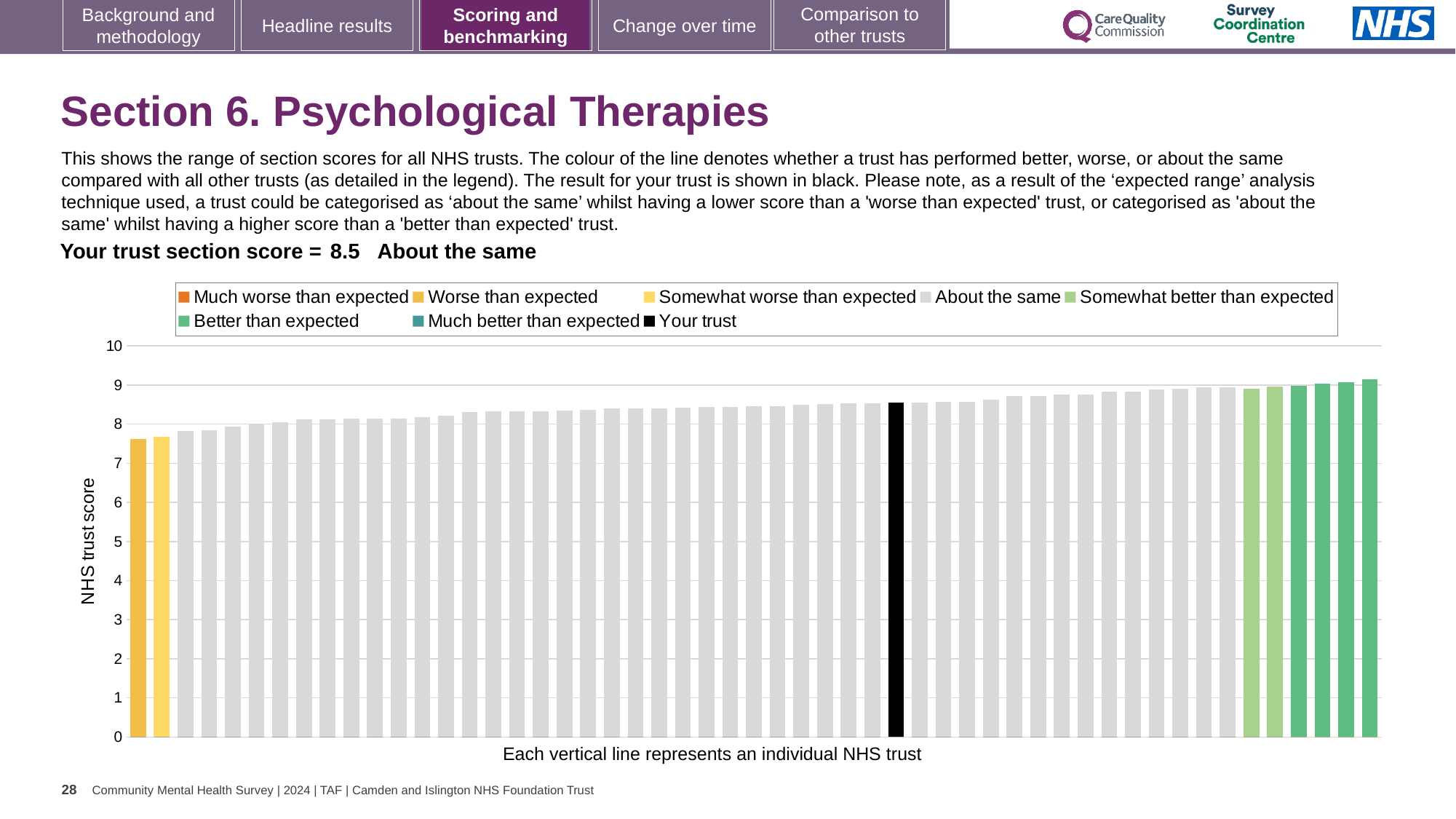
Is the value of the rightmost (highest) bar greater or less than 8? greater Is the value of the black 'Your trust' bar greater or less than 8? greater What is the label on the vertical axis of the chart? NHS trust score How many entries does the chart legend list? 8 Is the value of the leftmost (lowest) bar greater or less than 8? less Which is larger: the black 'Your trust' bar or the leftmost yellow bar? the black 'Your trust' bar What is the section score for your trust shown on the slide? 8.5 Which performance category is your trust placed in for this section? About the same What is the highest value shown on the vertical axis? 10 What colour is the bar representing your trust? black Do the bar values rise or fall from left to right along the x axis? rise What kind of chart is shown on the slide? bar chart